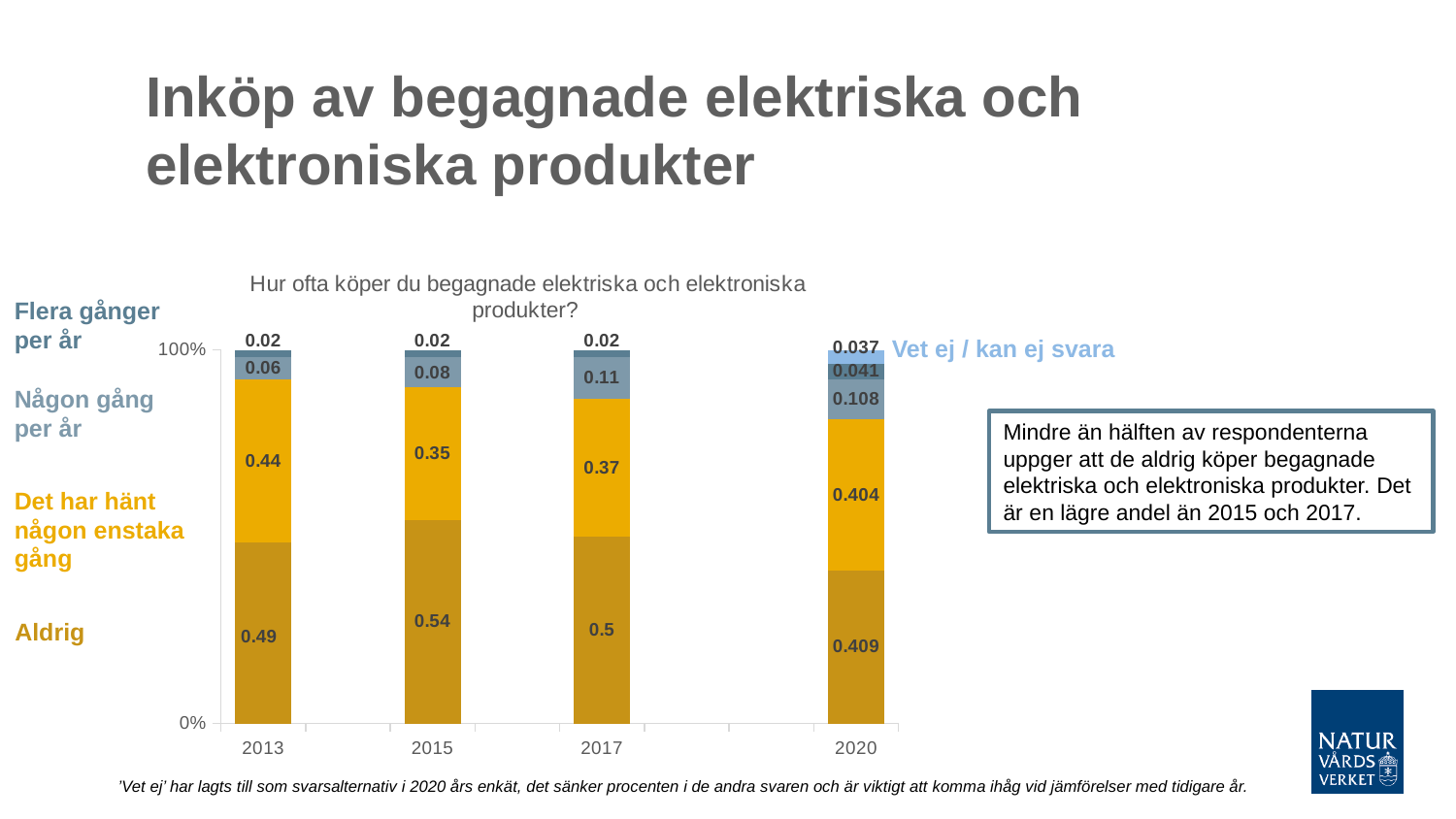
What is the difference between the 'Aldrig' values in 2015 and 2013? 0.05 In which year is the value for 'Aldrig' highest? 2015 What is the value for 'Det har hänt någon enstaka gång' in 2017? 0.37 What is the value for 'Aldrig' in 2015? 0.54 What kind of chart is shown on the slide? stacked bar chart Does the value for 'Någon gång per år' rise or fall from 2013 to 2017? rise In which year is the value for 'Aldrig' lowest? 2020 What is the title of the chart? Hur ofta köper du begagnade elektriska och elektroniska produkter? What is the value for 'Vet ej / kan ej svara' in 2020? 0.037 Which is larger: 'Det har hänt någon enstaka gång' in 2013 or in 2015? 2013 How many years are shown on the x axis? 4 What is the value for 'Någon gång per år' in 2020? 0.108